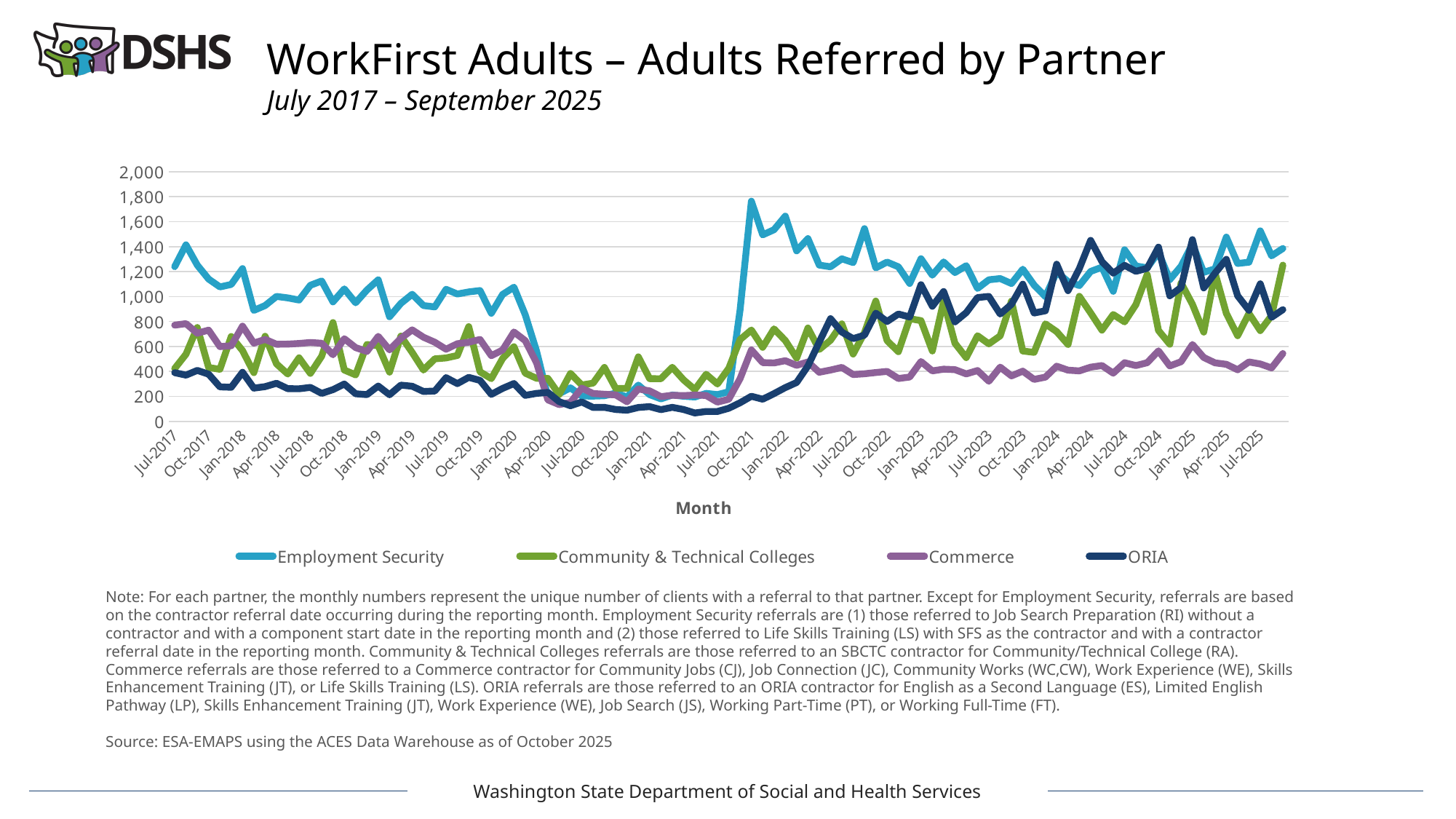
What is the title of the chart on the slide? WorkFirst Adults – Adults Referred by Partner At the last point on the chart (Jul-2025 onward), which is larger: ORIA or Commerce? ORIA What is the label of the x axis? Month How many series does the legend list? 4 In Jul-2017, which is larger: Commerce or Community & Technical Colleges? Commerce Is the value for Employment Security in Jul-2017 greater or less than 1,000? greater Is the value for ORIA in Jul-2017 greater or less than 600? less What kind of chart is shown on the slide? line chart Is the peak value for Employment Security around Oct-2021 greater or less than 1,600? greater Which series reaches the highest value anywhere on the chart? Employment Security Does the ORIA series rise or fall between Jul-2021 and Apr-2024? rise